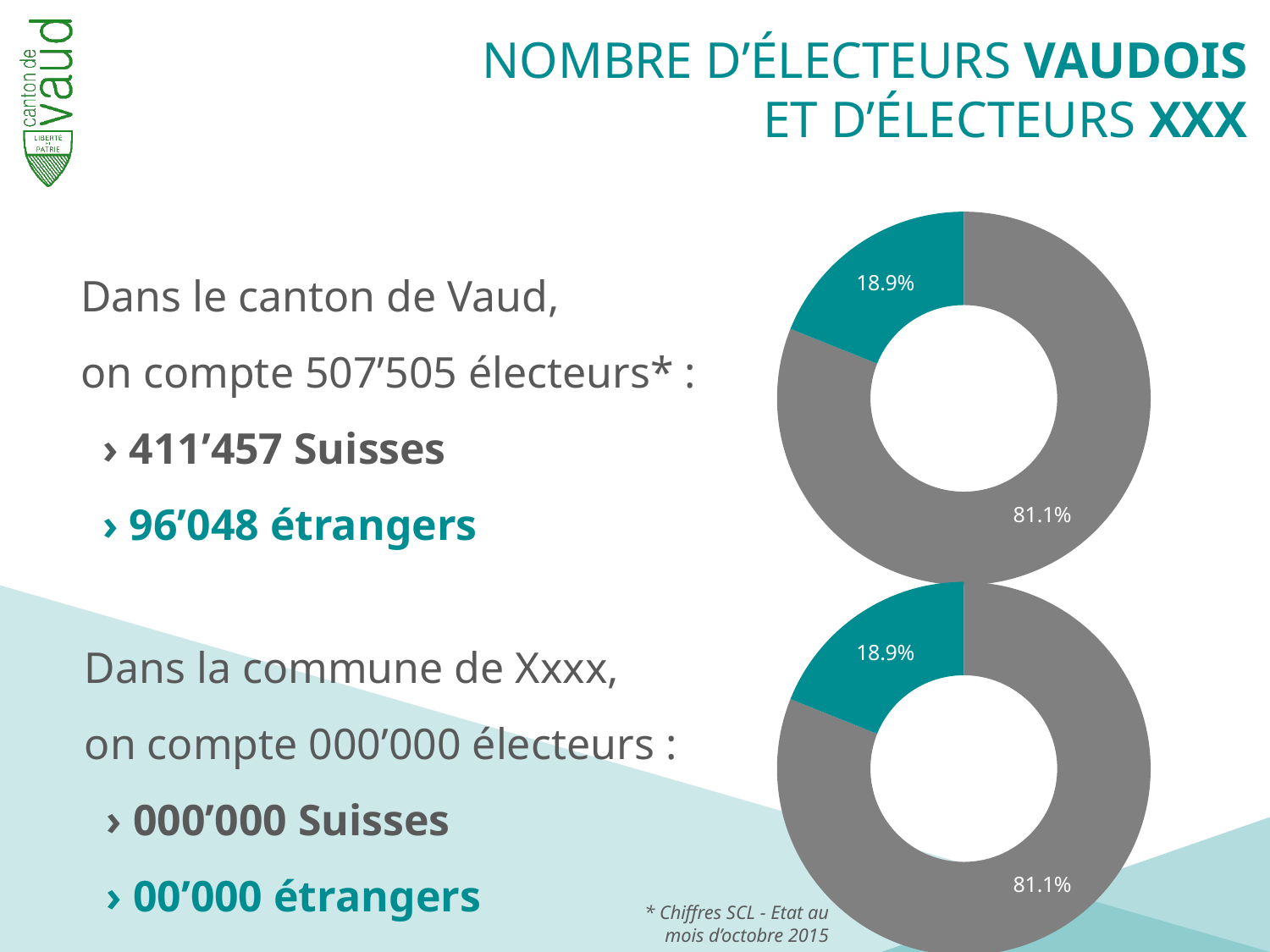
What kind of chart is the top chart on the right of the slide? doughnut chart In the top chart, what is the difference in percentage points between the grey slice and the teal slice? 62.2 In the bottom chart, which slice is the smallest? the teal slice (18.9%) How many slices does the bottom chart have? 2 In the top chart, what percentage is shown on the grey slice? 81.1% In the bottom chart, what percentage is shown on the grey slice? 81.1% How many slices does the top chart have? 2 How many doughnut charts are shown on the slide? 2 In the top chart, which slice is larger, the teal one or the grey one? the grey one In the bottom chart, what percentage is shown on the teal slice? 18.9% In the top chart, what percentage is shown on the teal slice? 18.9% In the bottom chart, is the value of the teal slice greater or less than 20%? less